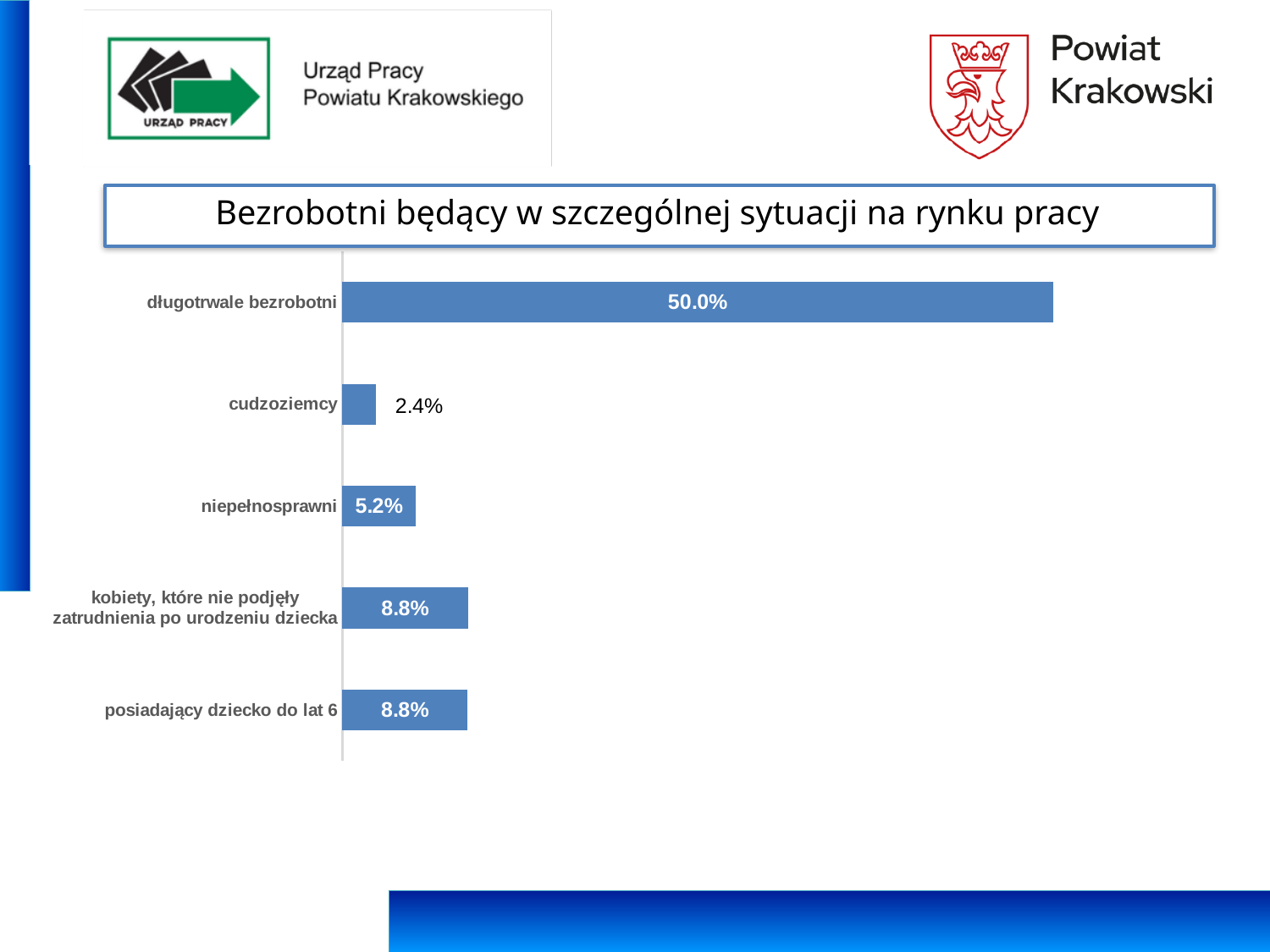
Which is larger, the value for niepełnosprawni or the value for cudzoziemcy? niepełnosprawni What is the value for posiadający dziecko do lat 6? 8.8% Which category has the lowest value? cudzoziemcy What is the value for cudzoziemcy? 2.4% How many categories are shown in the chart? 5 What is the value for niepełnosprawni? 5.2% Which category has the highest value? długotrwale bezrobotni What is the difference between the values for niepełnosprawni and cudzoziemcy? 2.8% What is the value for długotrwale bezrobotni? 50.0% What is the title of the chart? Bezrobotni będący w szczególnej sytuacji na rynku pracy What kind of chart is shown on the slide? bar chart What is the difference between the values for długotrwale bezrobotni and niepełnosprawni? 44.8%